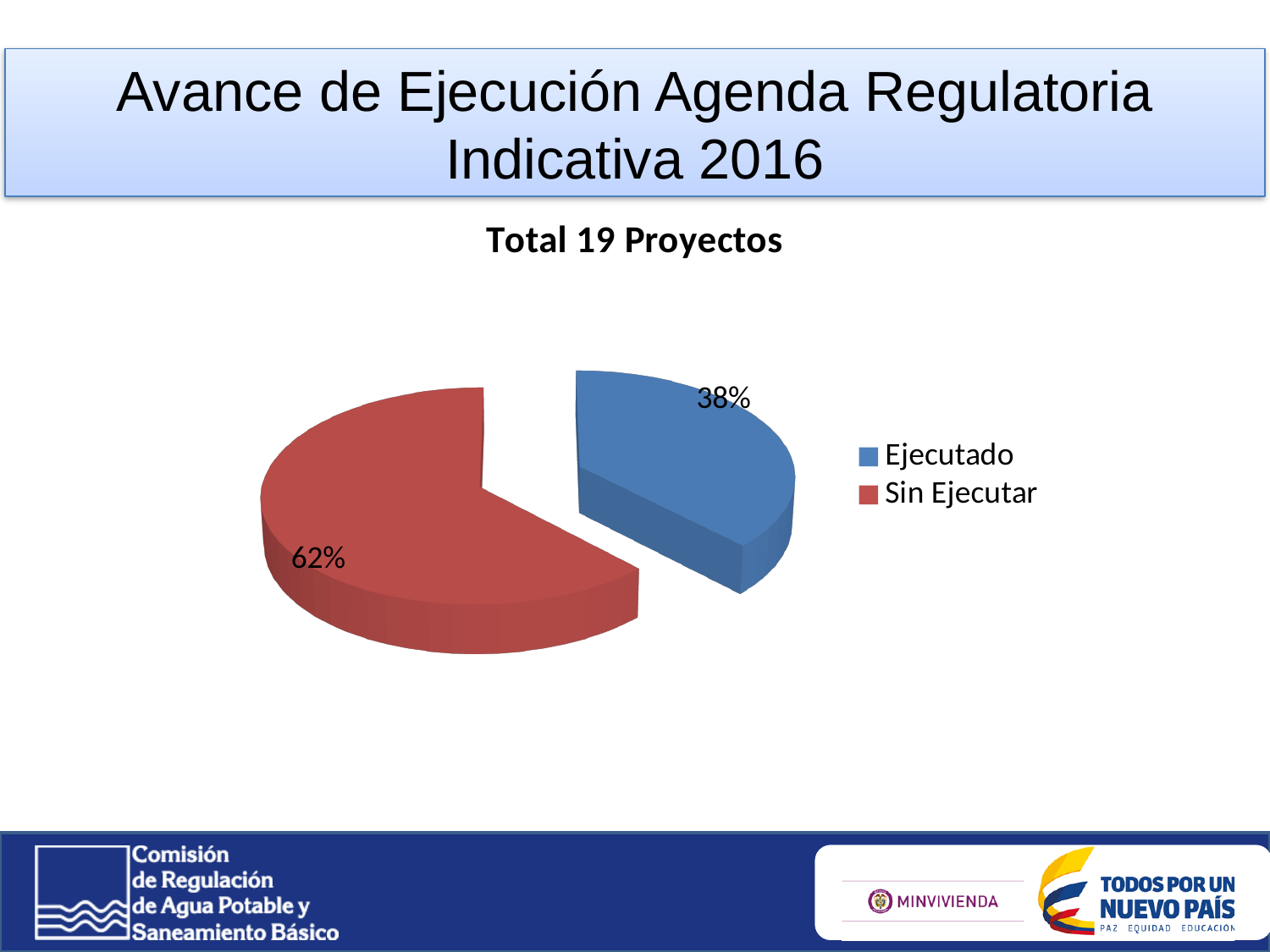
How many categories does the pie chart show? 2 Is the share for Ejecutado greater or less than 50%? less How many entries does the legend list? 2 What share of the pie is labelled Sin Ejecutar? 62% Which is larger, the Ejecutado slice or the Sin Ejecutar slice? Sin Ejecutar What kind of chart is shown on the slide? pie chart Which category has the largest slice of the pie? Sin Ejecutar What share of the pie is labelled Ejecutado? 38% What is the difference in percentage points between the Sin Ejecutar and Ejecutado slices? 24% Which category has the smallest slice of the pie? Ejecutado What colour is the Ejecutado slice? blue What is the chart's title? Total 19 Proyectos